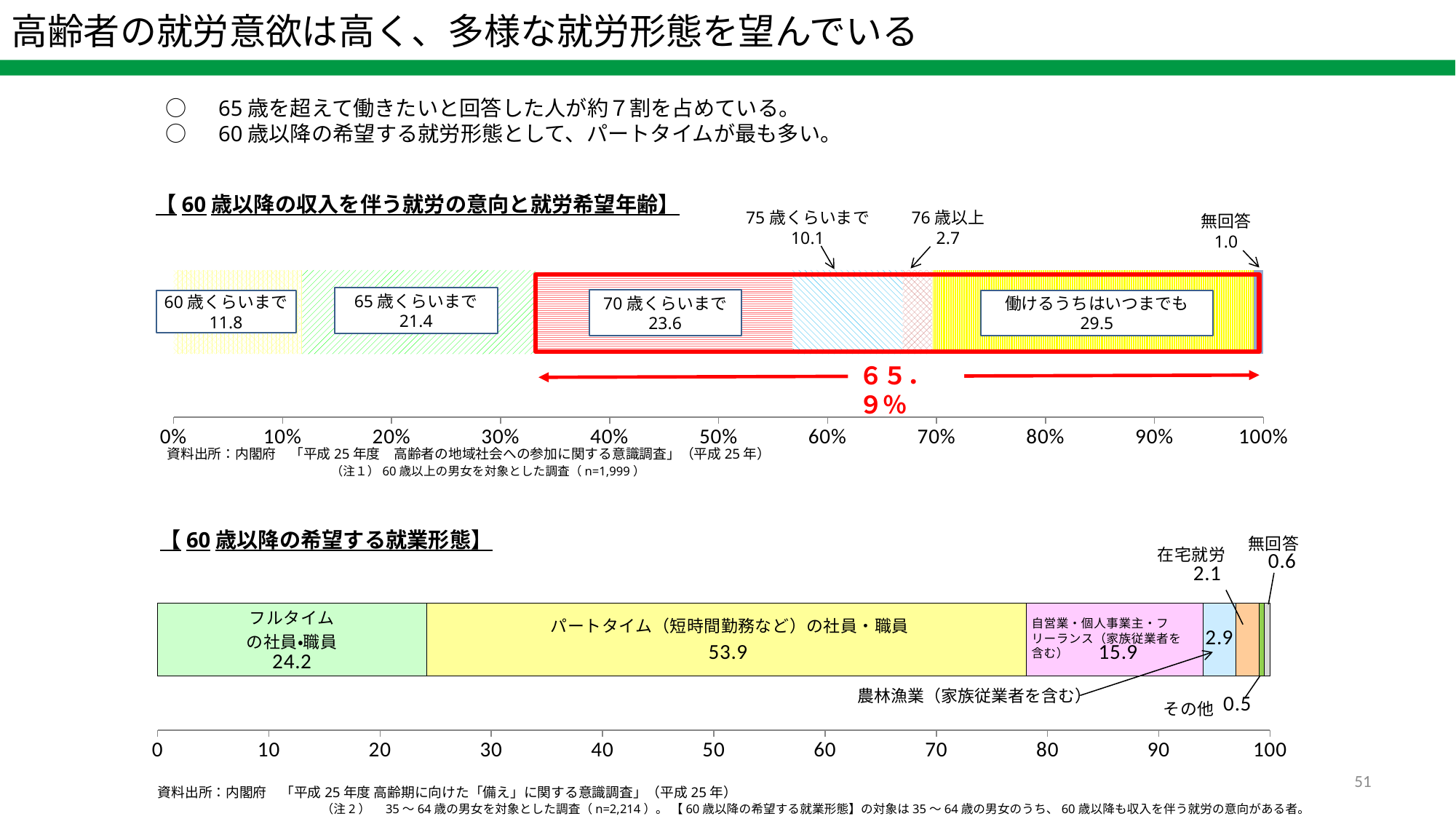
In the top chart (60歳以降の収入を伴う就労の意向と就労希望年齢), what is the value for 60歳くらいまで? 11.8 In the bottom chart (60歳以降の希望する就業形態), what is the value for 自営業・個人事業主・フリーランス（家族従業者を含む）? 15.9 In the top chart (60歳以降の収入を伴う就労の意向と就労希望年齢), what is the difference between 70歳くらいまで and 65歳くらいまで? 2.2 What kind of chart is the bottom chart (60歳以降の希望する就業形態)? Stacked bar chart In the top chart (60歳以降の収入を伴う就労の意向と就労希望年齢), how many segments make up the bar? 7 In the top chart (60歳以降の収入を伴う就労の意向と就労希望年齢), which segment has the largest value? 働けるうちはいつまでも In the bottom chart (60歳以降の希望する就業形態), what is the value for パートタイム（短時間勤務など）の社員・職員? 53.9 In the bottom chart (60歳以降の希望する就業形態), what is the difference between フルタイムの社員・職員 and 自営業・個人事業主・フリーランス? 8.3 In the top chart (60歳以降の収入を伴う就労の意向と就労希望年齢), which segment has the smallest value? 無回答 In the top chart (60歳以降の収入を伴う就労の意向と就労希望年齢), what percentage is shown by the red double-headed arrow? 65.9% In the bottom chart (60歳以降の希望する就業形態), which category has the largest value? パートタイム（短時間勤務など）の社員・職員 In the top chart (60歳以降の収入を伴う就労の意向と就労希望年齢), what is the value for 働けるうちはいつまでも? 29.5